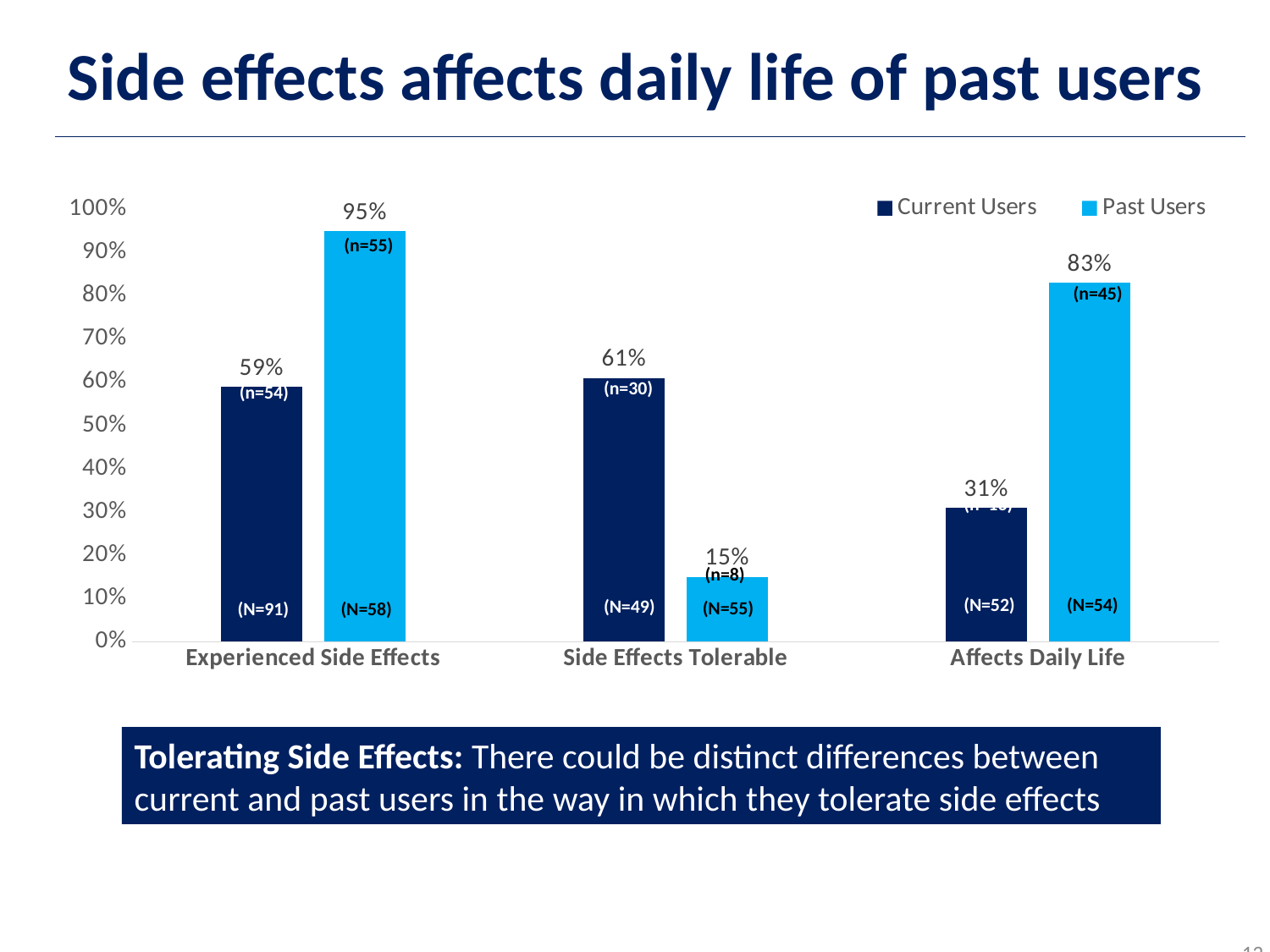
Which group has the larger value for Affects Daily Life, Current Users or Past Users? Past Users How many series does the legend list? 2 What percentage of Past Users said side effects affect daily life? 83% What is the difference between Past Users and Current Users for Experienced Side Effects? 36% What kind of chart is shown on the slide? Bar chart What percentage of Current Users found side effects tolerable? 61% What percentage of Past Users experienced side effects? 95% Which category has the highest value for Current Users? Side Effects Tolerable Which category has the lowest value for Past Users? Side Effects Tolerable What percentage of Current Users said side effects affect daily life? 31% How many categories are shown on the x axis? 3 What is the difference between Current Users and Past Users for Side Effects Tolerable? 46%